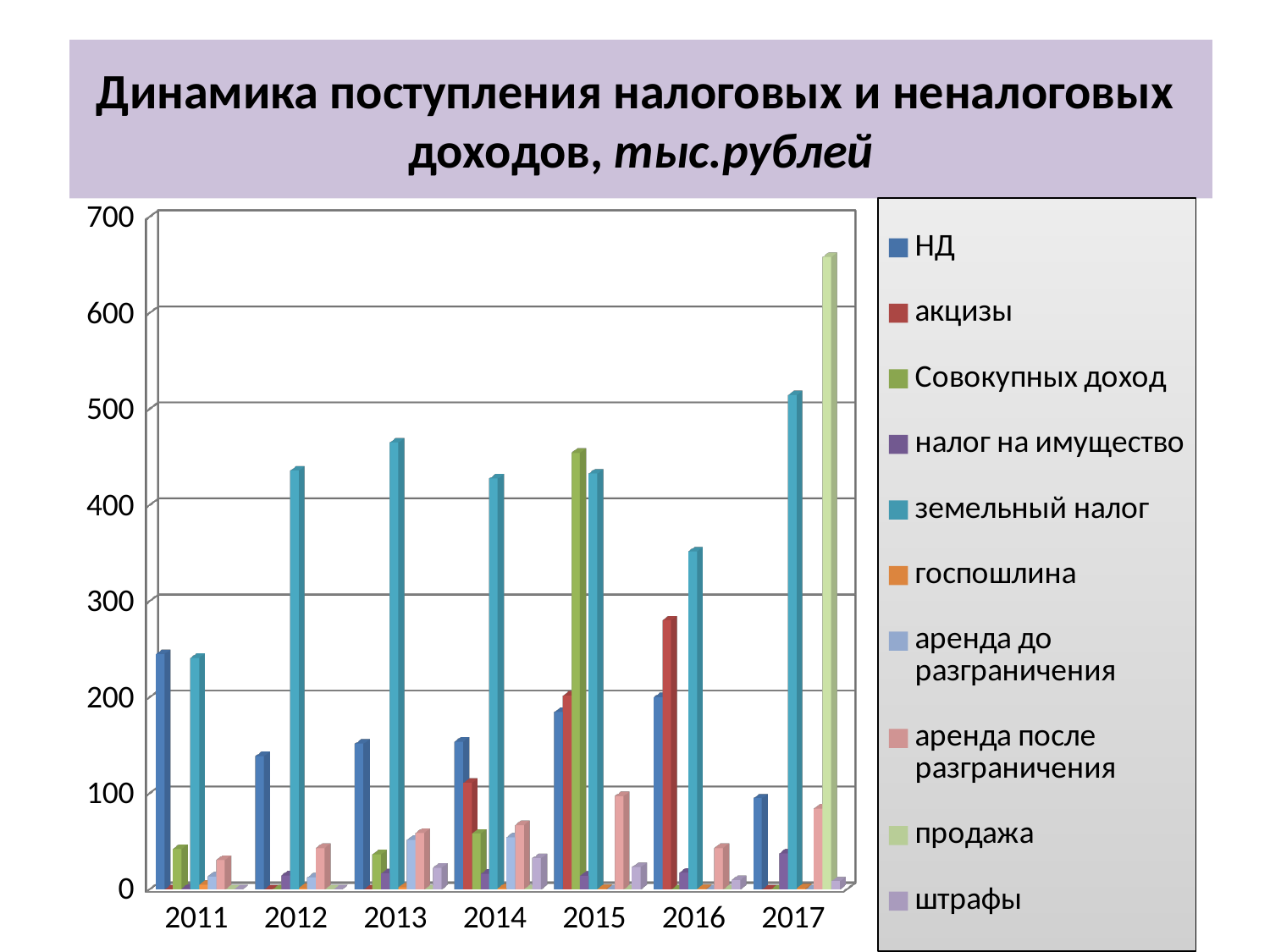
What kind of chart is shown on the slide? bar chart In which year is the value for земельный налог the highest? 2017 In 2016, which is larger: акцизы or НД? акцизы Do the values for акцизы rise or fall from 2014 to 2016? rise What is the title of the chart on the slide? Динамика поступления налоговых и неналоговых доходов, тыс.рублей In which year is the value for НД the lowest? 2017 Is the value for НД in 2011 greater or less than 200? greater How many series does the legend list? 10 How many years are shown along the x axis of the chart? 7 Is the value for продажа in 2017 greater or less than 600? greater Is the value for Совокупных доход in 2015 greater or less than 400? greater